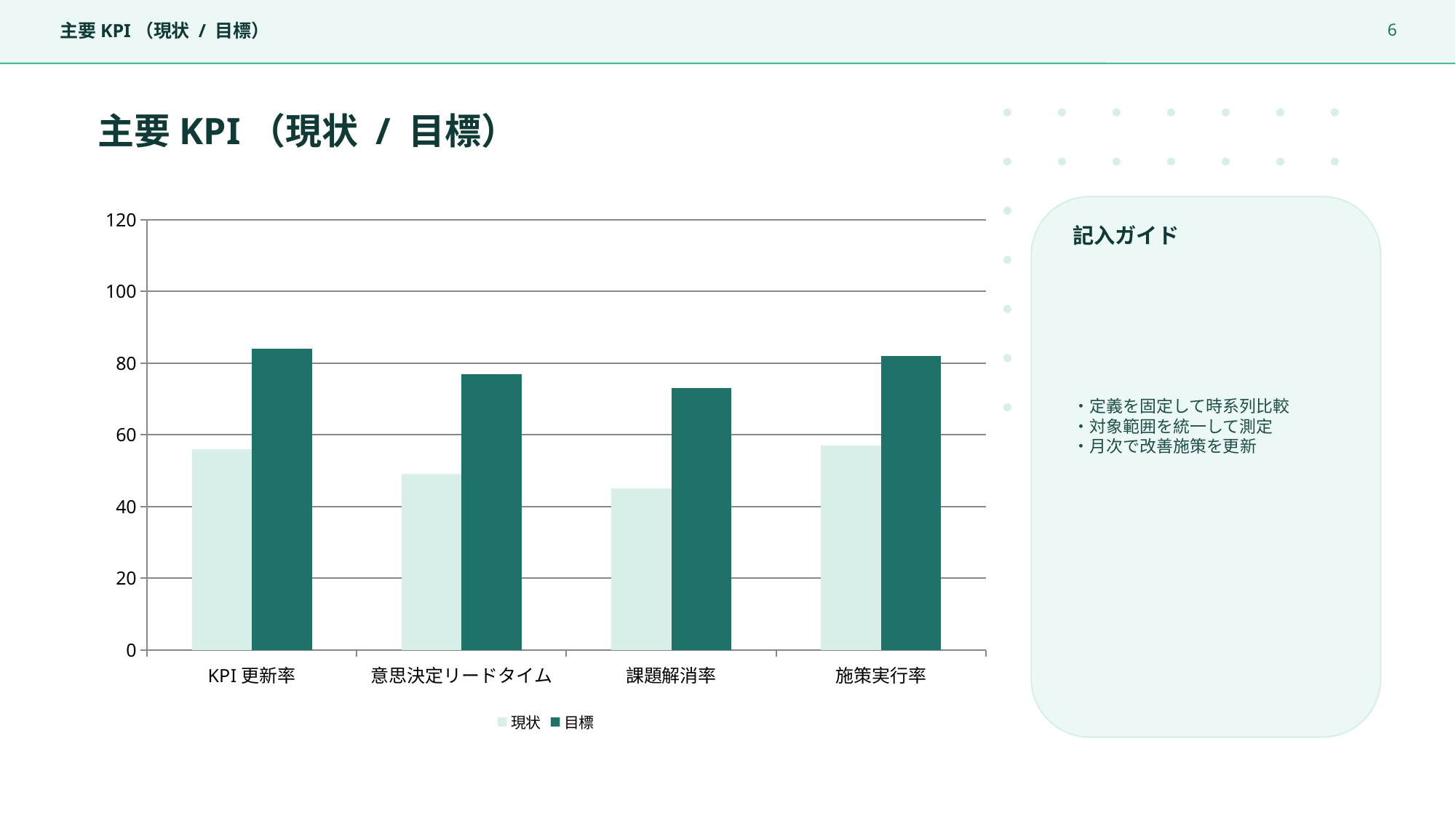
Is the 現状 value for KPI 更新率 greater or less than 40? greater How many categories are shown on the x axis of the chart? 4 How many series does the chart's legend list? 2 Which is larger, the 現状 value for KPI 更新率 or the 現状 value for 課題解消率? KPI 更新率 Is the 目標 value for 意思決定リードタイム greater or less than 60? greater Is the 目標 value for 課題解消率 greater or less than 80? less Which category has the lowest 現状 value? 課題解消率 What are the two series named in the chart's legend? 現状 and 目標 For 課題解消率, which is larger, the 現状 value or the 目標 value? 目標 What kind of chart is shown on the slide? bar chart